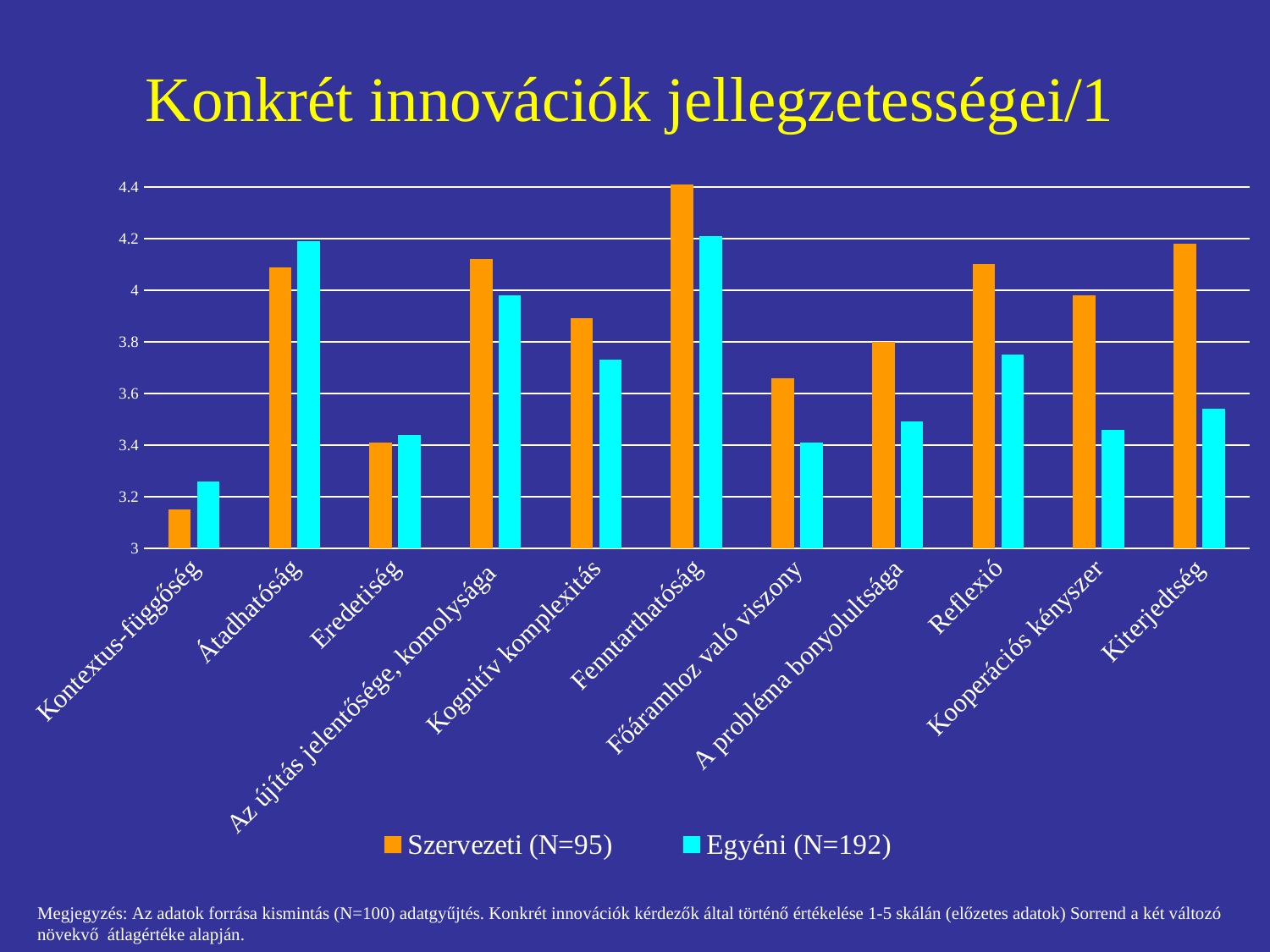
What is the title of the chart on the slide? Konkrét innovációk jellegzetességei/1 Is the Szervezeti (N=95) value for Kiterjedtség greater or less than 4? greater How many series does the legend list? 2 What kind of chart is shown on the slide? bar chart Is the Szervezeti (N=95) value for Reflexió greater or less than 4? greater Which category has the lowest value for the Szervezeti (N=95) series? Kontextus-függőség Which category has the highest value for the Szervezeti (N=95) series? Fenntarthatóság For Kontextus-függőség, which series has the larger value, Szervezeti (N=95) or Egyéni (N=192)? Egyéni (N=192) Which category has the lowest value for the Egyéni (N=192) series? Kontextus-függőség Is the Egyéni (N=192) value for Főáramhoz való viszony greater or less than 3.6? less For Kiterjedtség, which series has the larger value, Szervezeti (N=95) or Egyéni (N=192)? Szervezeti (N=95) How many categories are shown along the x axis of the chart? 11